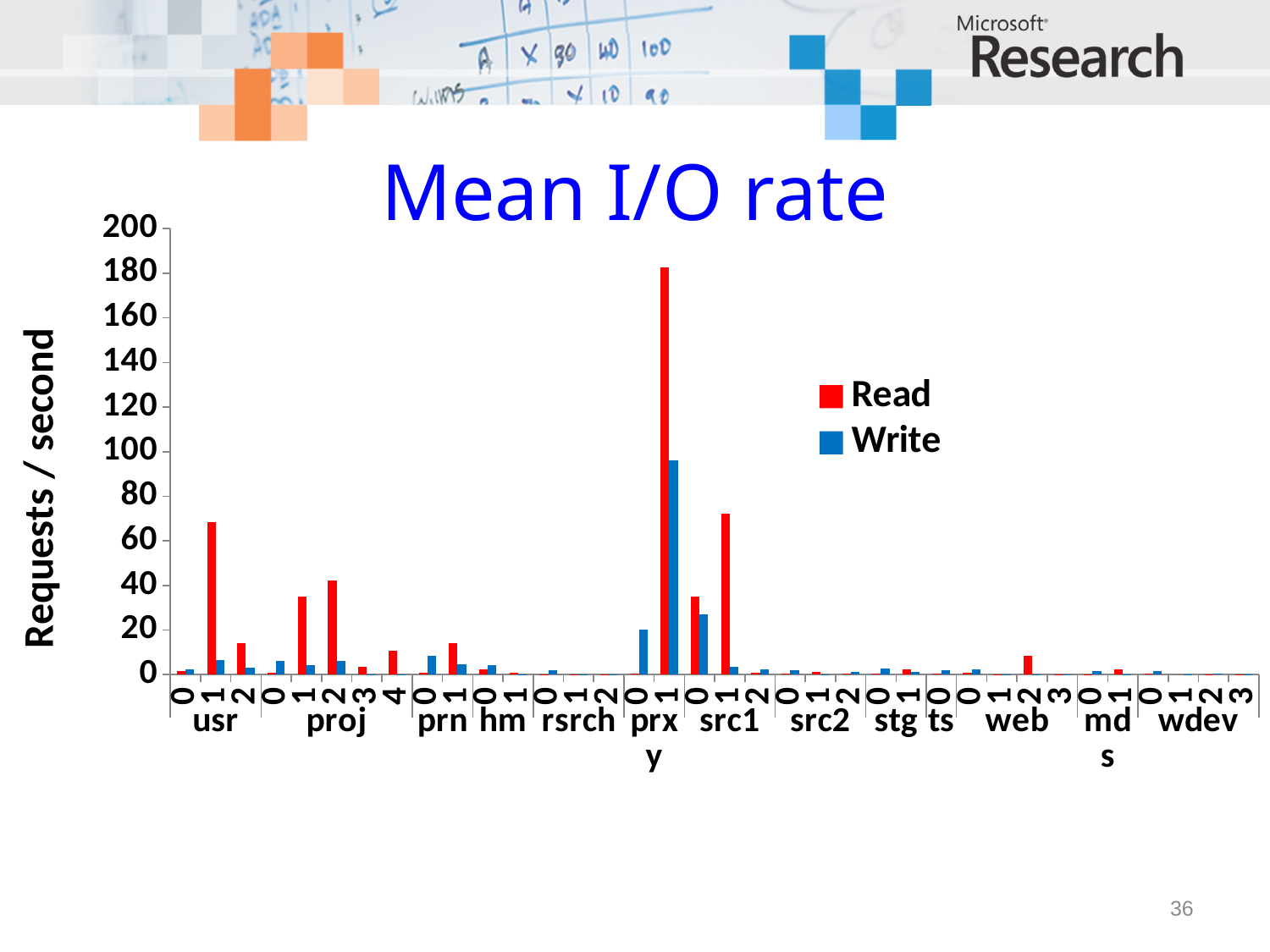
How many series does the legend list? 2 For prxy 1, which is larger, the Read value or the Write value? Read Is the Read value for usr 1 greater or less than 60? greater What is the label on the vertical axis? Requests / second Is the Read value for prxy 1 greater or less than 160? greater Which volume has the highest Read value? prxy 1 Is the Read value for proj 1 greater or less than 40? less What is the title of the chart? Mean I/O rate Which is larger, the Read value for prxy 1 or the Read value for src1 1? prxy 1 Which volume has the highest Write value? prxy 1 What kind of chart is shown on the slide? bar chart